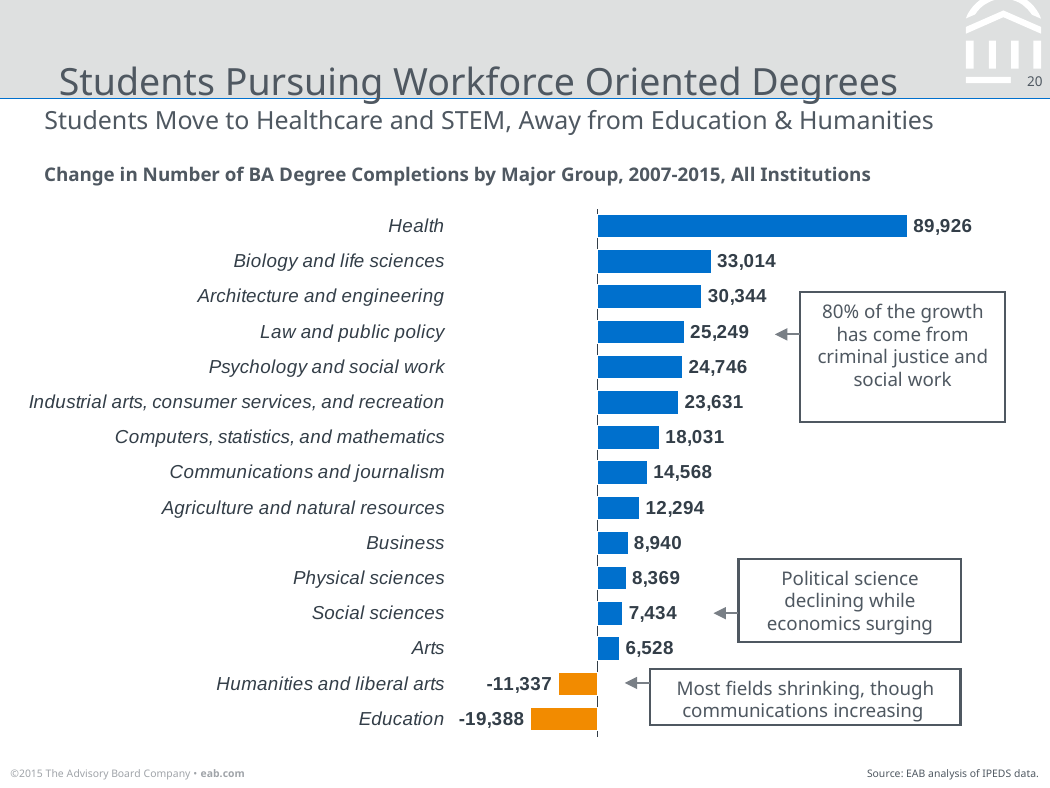
What is the value for Education? -19,388 What is the value for Computers, statistics, and mathematics? 18,031 What is the difference between the values for Business and Physical sciences? 571 Which is larger, the value for Social sciences or the value for Arts? Social sciences What is the value for Health? 89,926 What is the title of the chart? Change in Number of BA Degree Completions by Major Group, 2007-2015, All Institutions Which major group has the highest value? Health Which major group has the lowest value? Education How many major groups are shown in the chart? 15 What kind of chart is shown on the slide? Bar chart What is the difference between the values for Health and Biology and life sciences? 56,912 What is the value for Humanities and liberal arts? -11,337